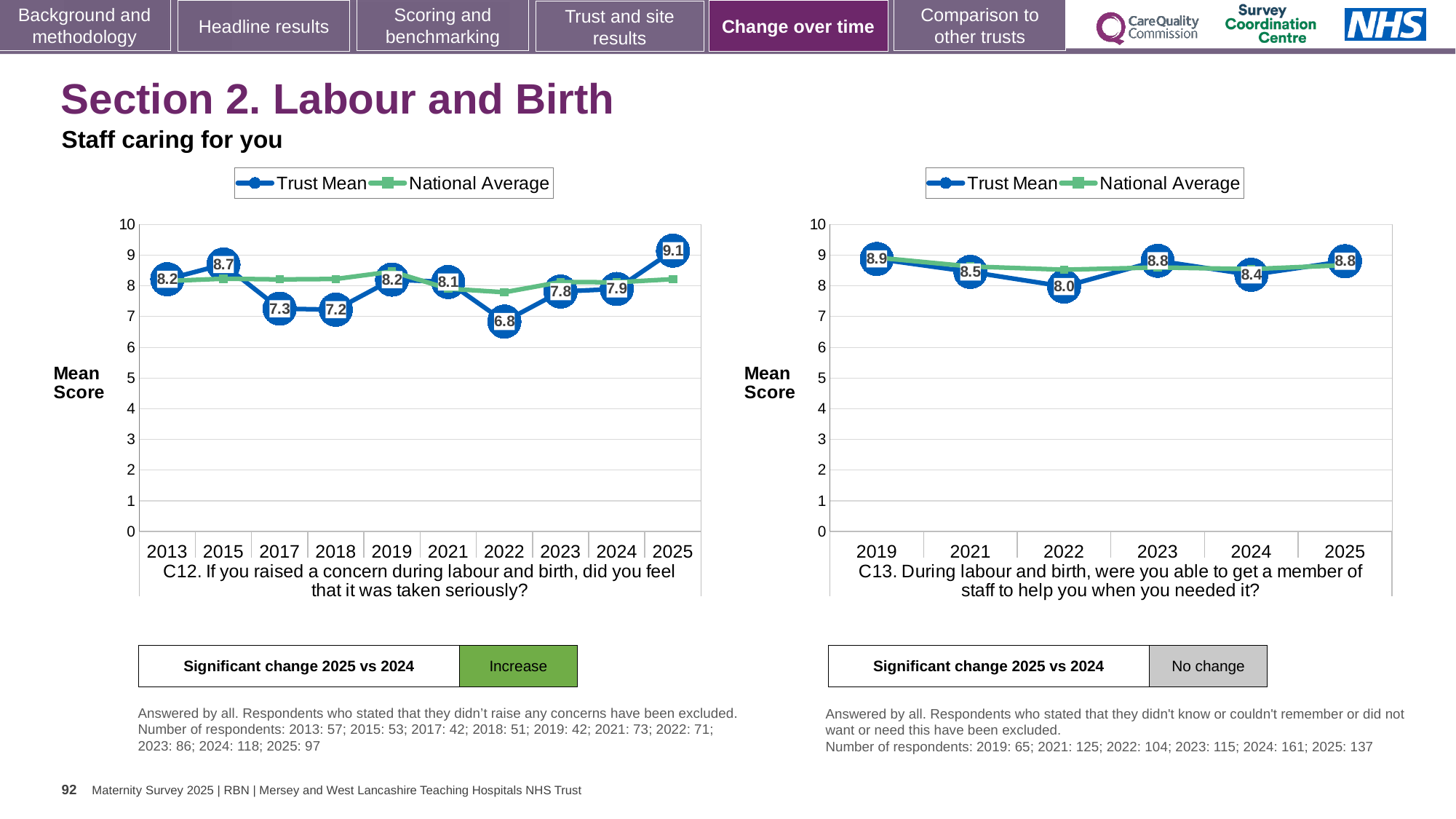
In the C13 chart (right), which year has the highest Trust Mean? 2019 In the C13 chart (right), what is the Trust Mean for 2022? 8.0 In the C12 chart (left), what is the Trust Mean for 2025? 9.1 In the C12 chart (left), how many years are plotted on the x axis? 10 In the C12 chart (left), what is the difference between the Trust Mean for 2025 and 2024? 1.2 In the C13 chart (right), is the National Average for 2022 greater or less than 8? greater In the C12 chart (left), what is the Trust Mean for 2022? 6.8 In the C12 chart (left), which year has the lowest Trust Mean? 2022 What kind of chart is the C12 chart (left)? Line chart In the C13 chart (right), is the Trust Mean for 2021 or 2024 larger? 2021 In the C12 chart (left), which year has the highest Trust Mean? 2025 How many series does the legend of the C13 chart (right) list? 2